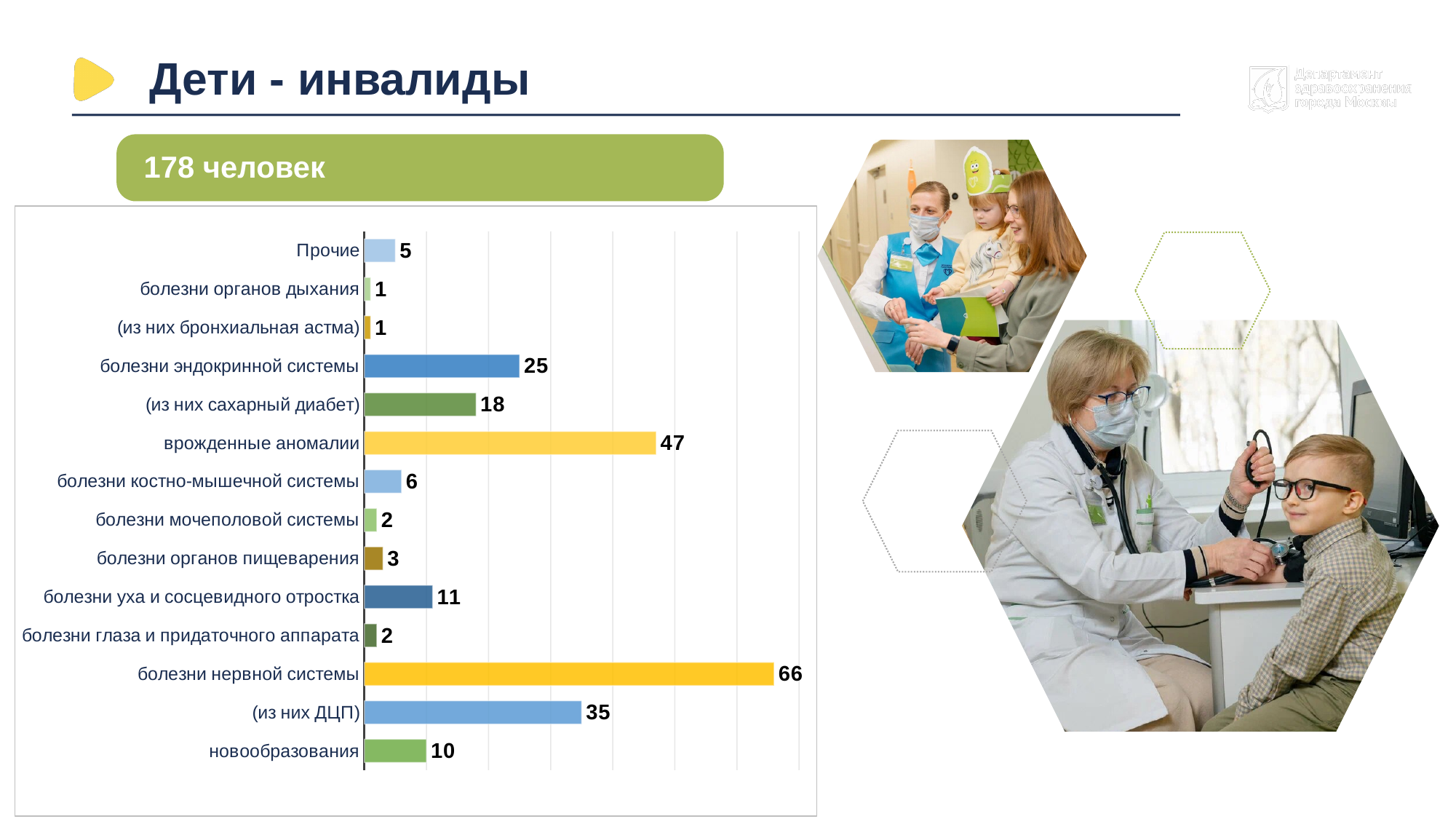
What is the value for "новообразования"? 10 What total number of people is stated in the green box above the chart? 178 человек What type of chart is shown on the slide? bar chart Which category has the highest value? болезни нервной системы What is the difference between "болезни эндокринной системы" and "(из них сахарный диабет)"? 7 Which is larger: "болезни уха и сосцевидного отростка" or "болезни костно-мышечной системы"? болезни уха и сосцевидного отростка How many categories are shown in the chart? 14 What is the value for "болезни нервной системы"? 66 What is the value for "болезни эндокринной системы"? 25 What is the value for "врожденные аномалии"? 47 What is the difference between "болезни нервной системы" and "врожденные аномалии"? 19 What is the value for "(из них ДЦП)"? 35